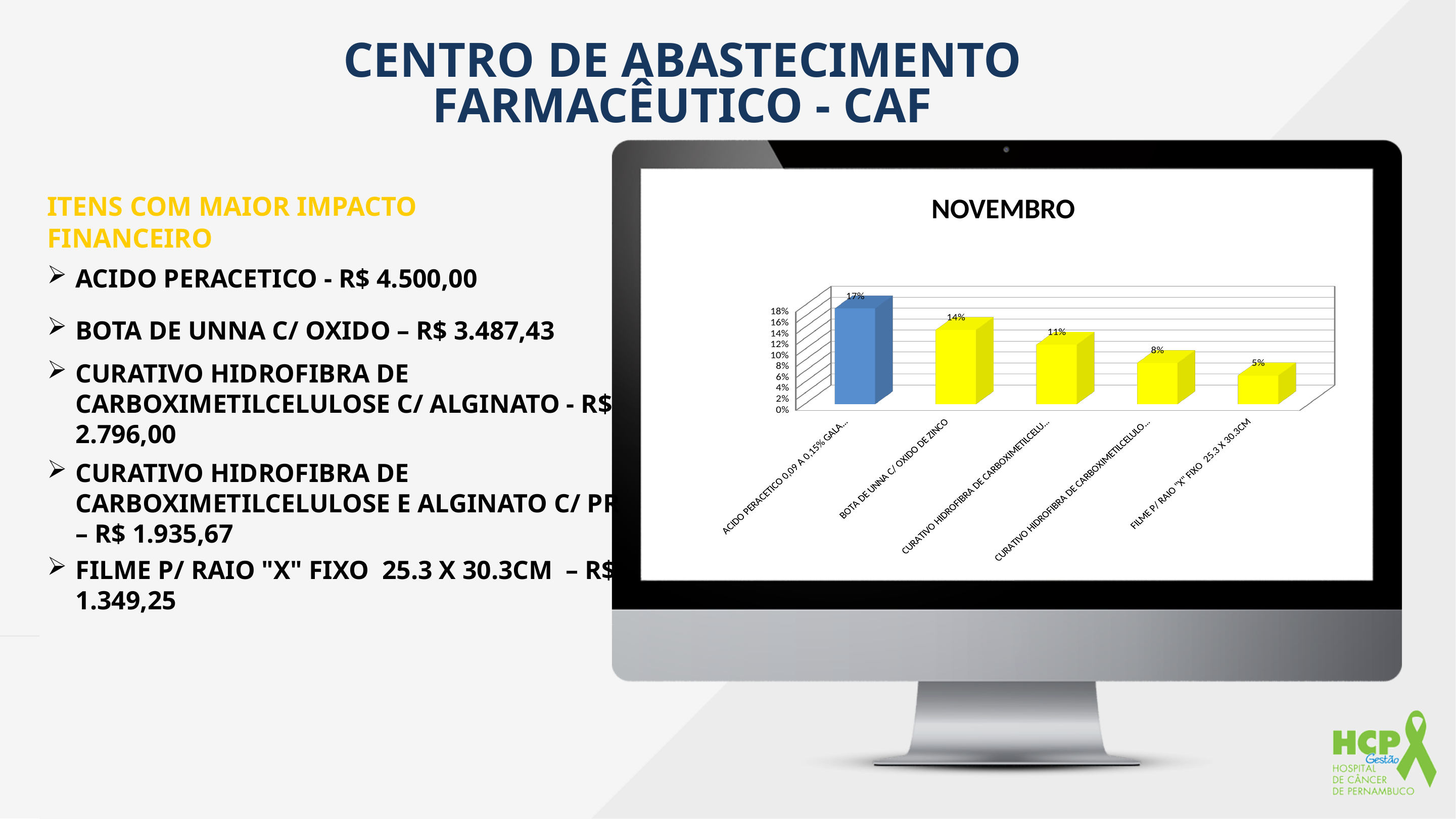
What type of chart is shown on the slide? bar chart What is the value for FILME P/ RAIO "X" FIXO 25.3 X 30.3CM? 5% Which category has the highest value? ACIDO PERACETICO 0,09 A 0,15% GALA... Which is larger, the value for BOTA DE UNNA C/ OXIDO DE ZINCO or the value of the fourth bar? BOTA DE UNNA C/ OXIDO DE ZINCO How many bars does the chart have? 5 What is the value of the first bar (ACIDO PERACETICO)? 17% Which category has the lowest value? FILME P/ RAIO "X" FIXO 25.3 X 30.3CM What is the title of the chart? NOVEMBRO What is the value of the third bar from the left? 11% Do the values rise or fall from left to right along the x axis? fall What is the value for BOTA DE UNNA C/ OXIDO DE ZINCO? 14% What is the difference between the value for ACIDO PERACETICO and the value for FILME P/ RAIO "X" FIXO 25.3 X 30.3CM? 12%